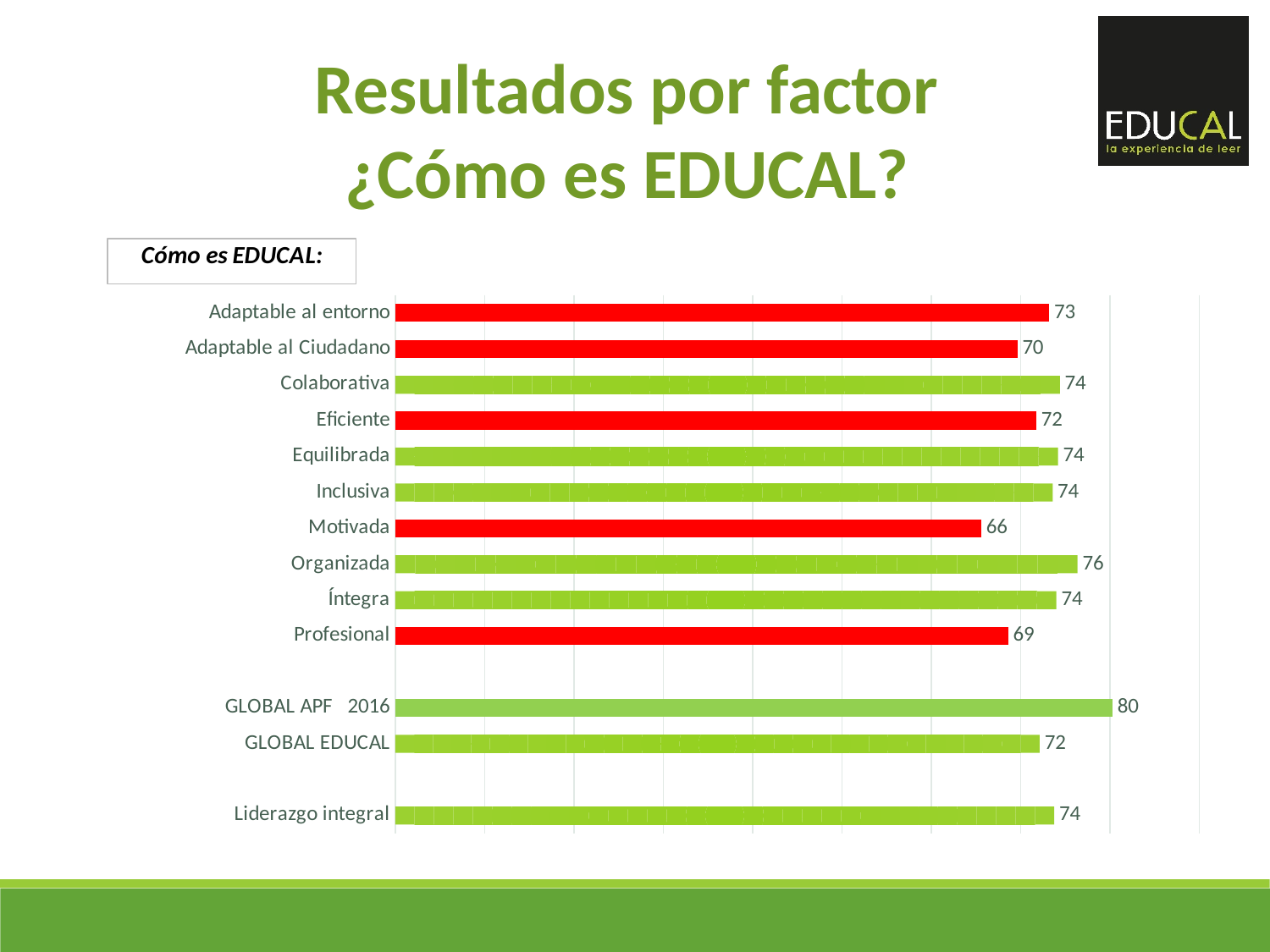
What is the value for Organizada? 76 What is the difference between GLOBAL APF 2016 and GLOBAL EDUCAL? 8 What colour is the bar for Motivada? Red Which category has the lowest value? Motivada Which is larger, Adaptable al entorno or Eficiente? Adaptable al entorno What is the difference between Organizada and Profesional? 7 What is the value for GLOBAL APF 2016? 80 How many bars are shown in the chart? 13 What is the value for Motivada? 66 Which category has the highest value? GLOBAL APF 2016 What is the value for Adaptable al Ciudadano? 70 What kind of chart is shown on the slide? Bar chart